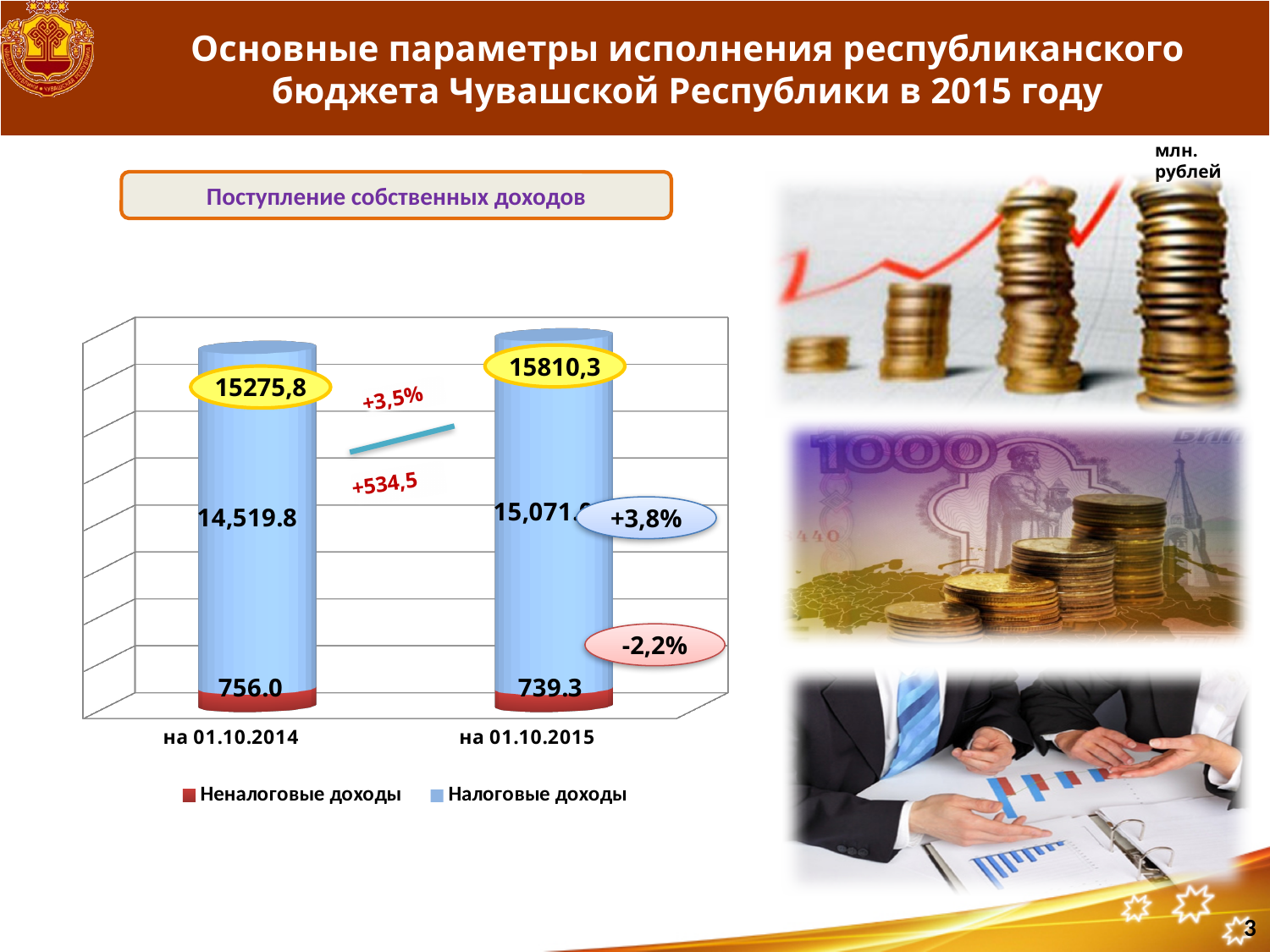
What is the title shown above the chart? Поступление собственных доходов What is the total of the stacked bar for на 01.10.2014? 15275,8 What is the value of Налоговые доходы for на 01.10.2014? 14,519.8 How many series does the legend list? 2 Does the total of the stacked bars rise or fall from на 01.10.2014 to на 01.10.2015? rise What is the total of the stacked bar for на 01.10.2015? 15810,3 How many categories are shown on the x axis of the chart? 2 Which has the larger value for Неналоговые доходы, на 01.10.2014 or на 01.10.2015? на 01.10.2014 What is the value of Неналоговые доходы for на 01.10.2015? 739.3 What is the difference between Неналоговые доходы for на 01.10.2014 and на 01.10.2015? 16.7 What kind of chart is shown on the slide? bar chart What is the value of Неналоговые доходы for на 01.10.2014? 756.0